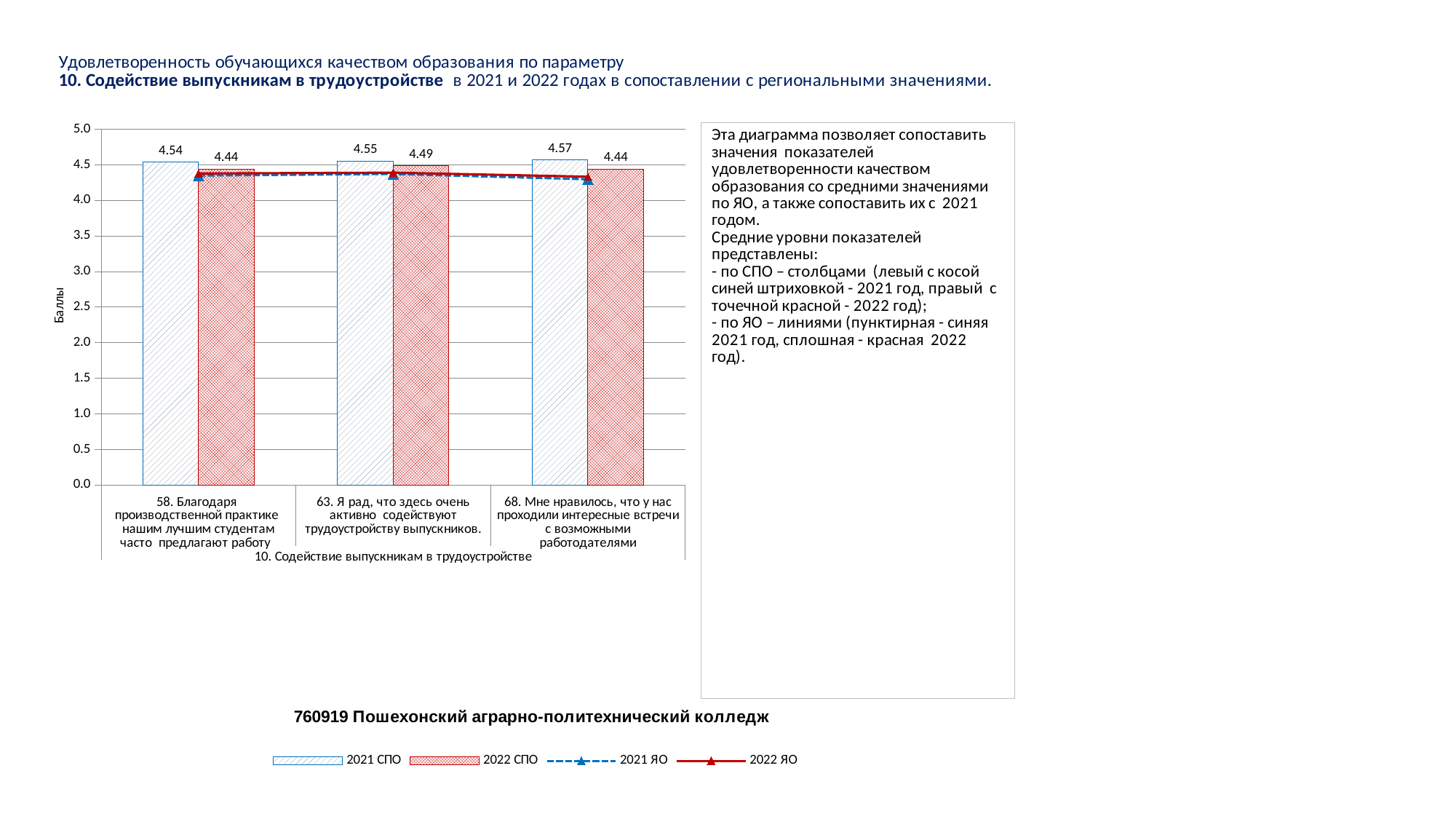
Which category has the highest value in the 2021 СПО series? 68. Мне нравилось, что у нас проходили интересные встречи с возможными работодателями What is the value of the 2022 СПО series for category 63 (Я рад, что здесь очень активно содействуют трудоустройству выпускников)? 4.49 What is the label of the vertical axis of the chart? Баллы What is the difference between the 2021 СПО and 2022 СПО values for category 68? 0.13 How many series does the chart legend list? 4 What is the value of the 2021 СПО series for category 68 (Мне нравилось, что у нас проходили интересные встречи с возможными работодателями)? 4.57 For category 63, which is larger: the 2021 СПО value or the 2022 СПО value? 2021 СПО Is the value of the 2021 ЯО line for category 68 greater or less than 4.0? greater What is the value of the 2021 СПО series for category 58 (Благодаря производственной практике нашим лучшим студентам часто предлагают работу)? 4.54 Which category has the highest value in the 2022 СПО series? 63. Я рад, что здесь очень активно содействуют трудоустройству выпускников. What is the difference between the 2021 СПО and 2022 СПО values for category 58? 0.10 How many categories are shown on the x axis of the chart? 3